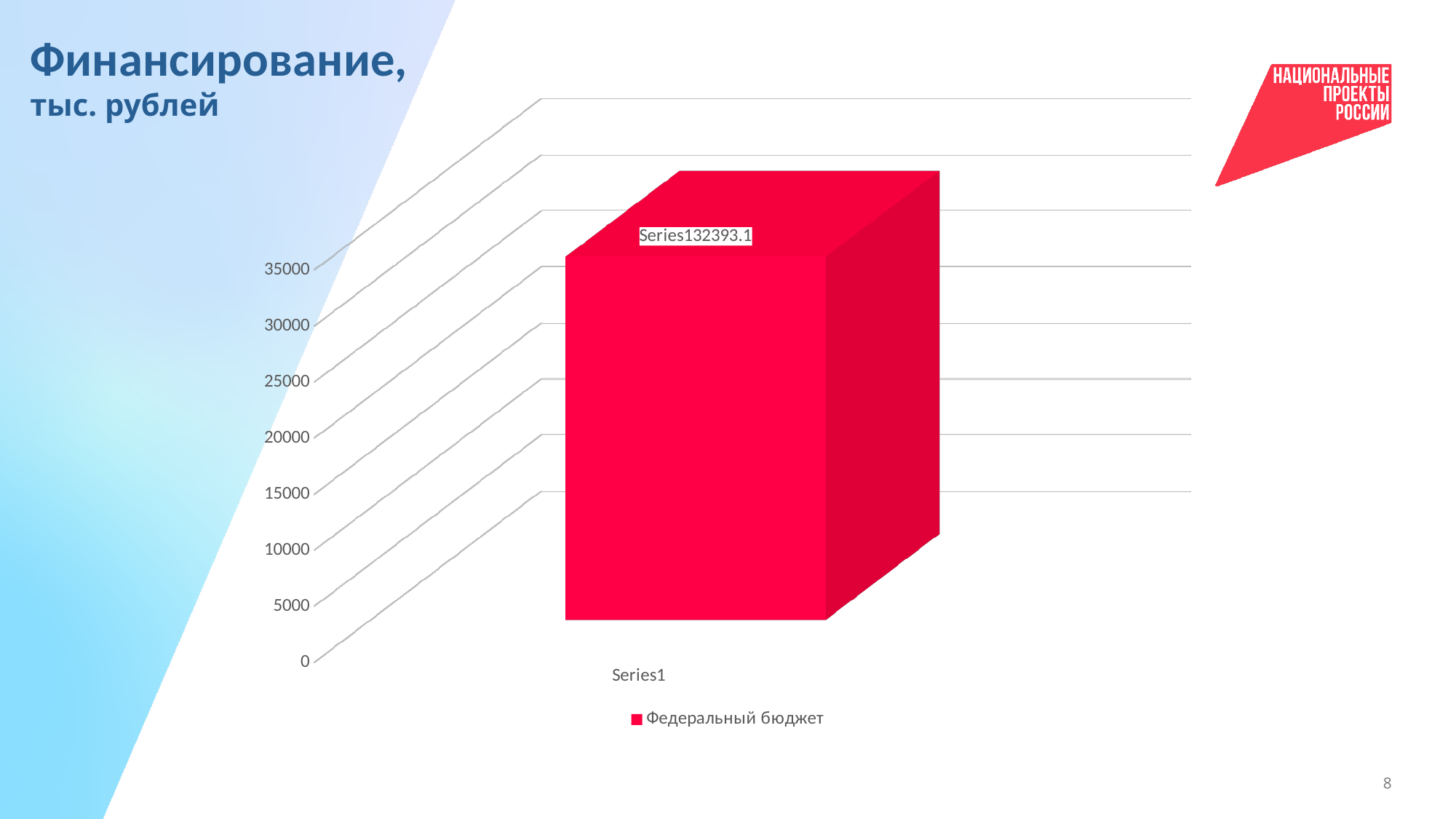
How many series does the legend list? 1 Is the value of the bar greater or less than 30000? greater What is the category label shown on the x axis under the bar? Series1 Is the value of the bar greater or less than 35000? less What is the value for Федеральный бюджет shown in the chart? 32393.1 What is the highest tick value shown on the vertical axis? 35000 How many bars are plotted in the chart? 1 What kind of chart is shown on the slide? bar chart What is the name of the series listed in the legend? Федеральный бюджет What value is printed on the data label of the bar in the chart? 32393.1